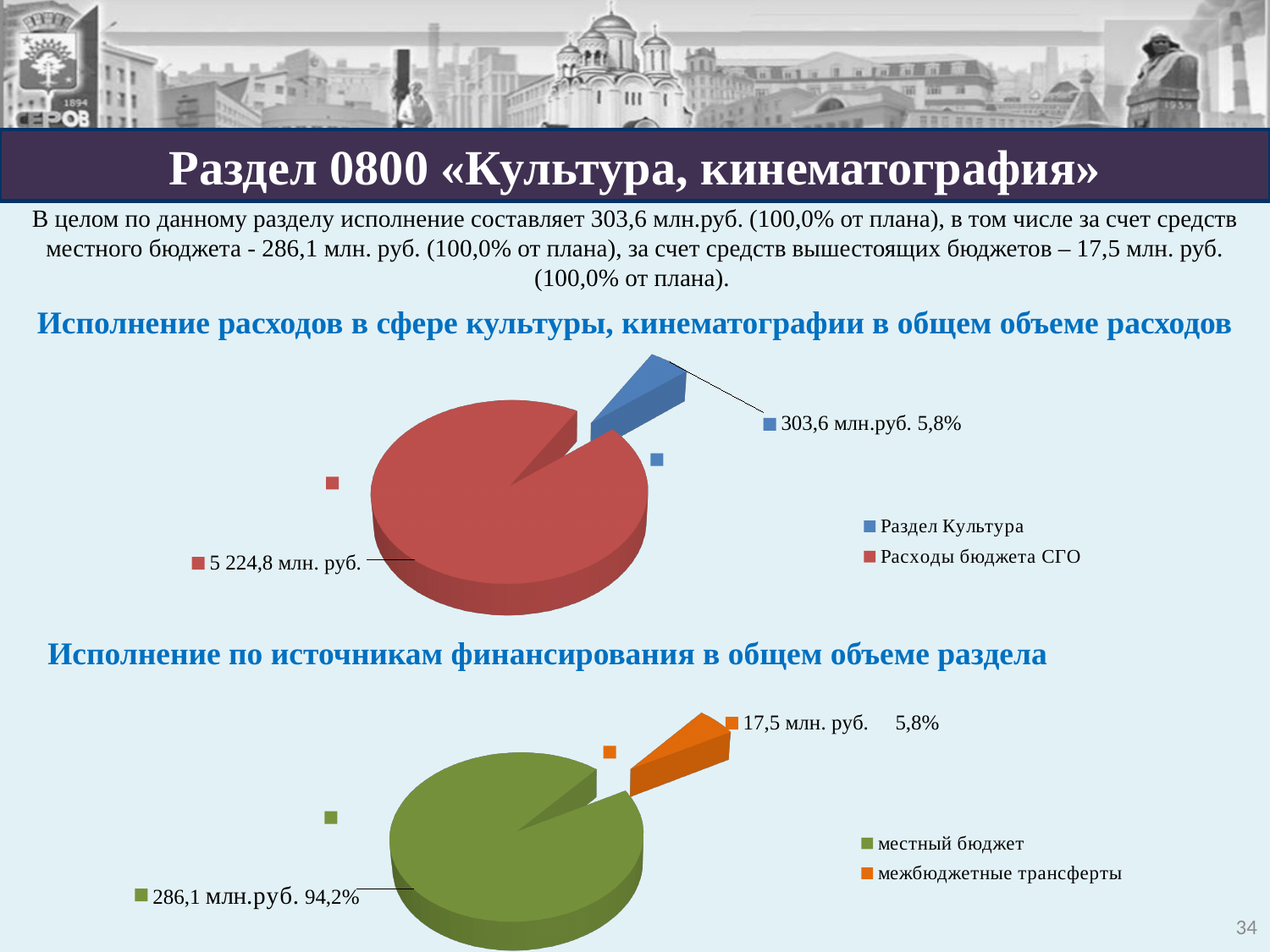
In the bottom chart, what is the difference between местный бюджет and межбюджетные трансферты? 268,6 млн. руб. In the bottom chart (Исполнение по источникам финансирования в общем объеме раздела), what is the value for местный бюджет? 286,1 млн.руб. In the bottom chart, what is the value for межбюджетные трансферты? 17,5 млн. руб. In the top chart, how many slices does the pie have? 2 What kind of chart is the top chart? Pie chart In the top chart, what is the value for Расходы бюджета СГО? 5 224,8 млн. руб. In the bottom chart, what colour is the slice for межбюджетные трансферты? Orange In the bottom chart, which slice is the smallest? межбюджетные трансферты In the top chart, what share of the pie does Раздел Культура represent? 5,8% In the bottom chart, what share of the pie does местный бюджет represent? 94,2% In the top chart, which slice is the largest? Расходы бюджета СГО In the top chart (Исполнение расходов в сфере культуры, кинематографии в общем объеме расходов), what is the value for Раздел Культура? 303,6 млн.руб.